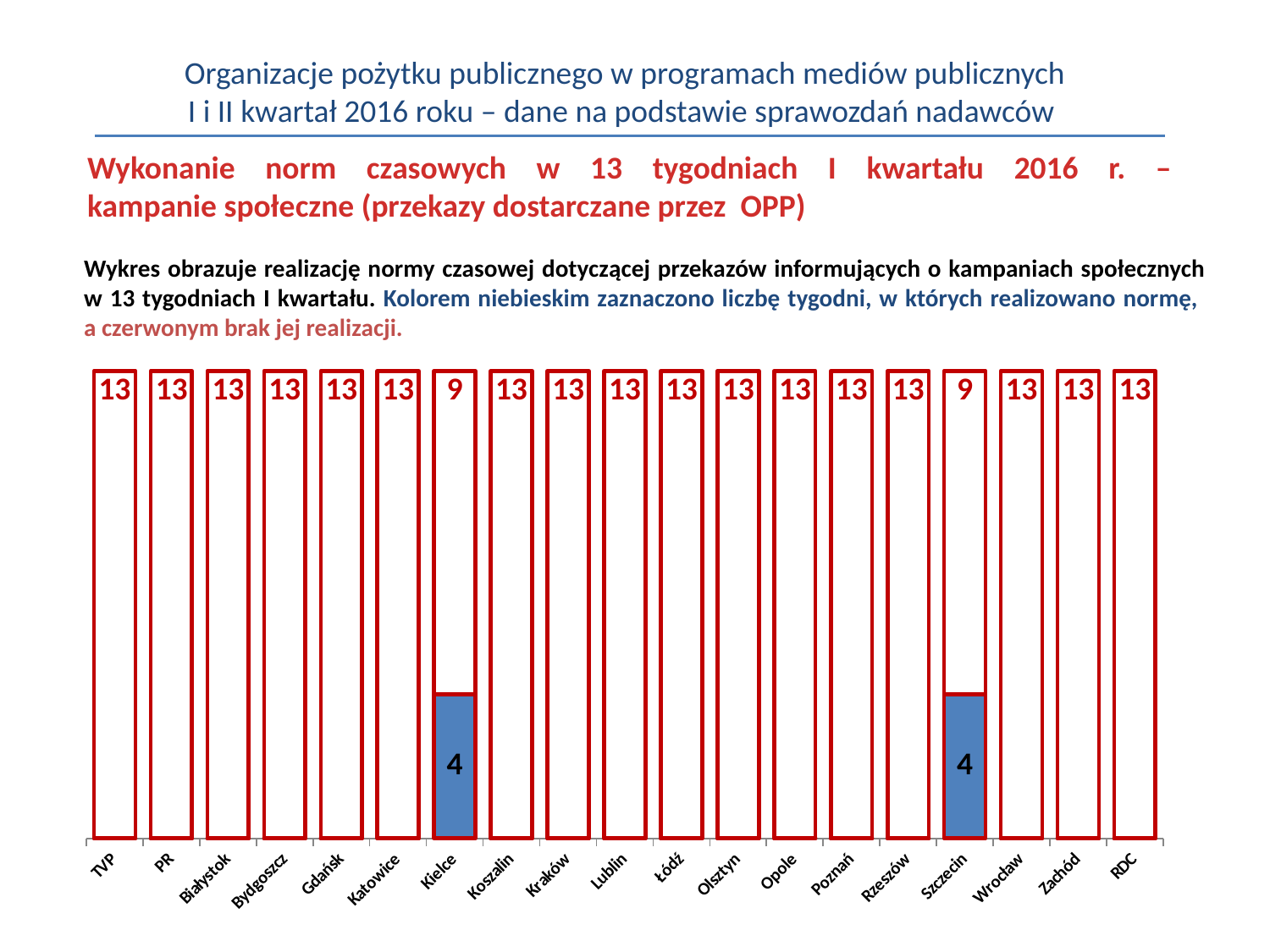
How many categories are shown on the x axis of the chart? 19 What is the red value shown for Kraków? 13 What is the total of the stacked bar for Kielce (red plus blue)? 13 What is the red value shown for RDC? 13 What is the blue (norm met) value shown for Szczecin? 4 Which is larger, the red value for Szczecin or the red value for Wrocław? Wrocław What is the red (norm not met) value shown for Kielce? 9 Which category is the first on the x axis of the chart? TVP What is the difference between the red value for Opole and the red value for Szczecin? 4 Which categories have a blue segment in the chart? Kielce and Szczecin What is the difference between the red value for Kielce and the blue value for Kielce? 5 What kind of chart is shown on the slide? bar chart